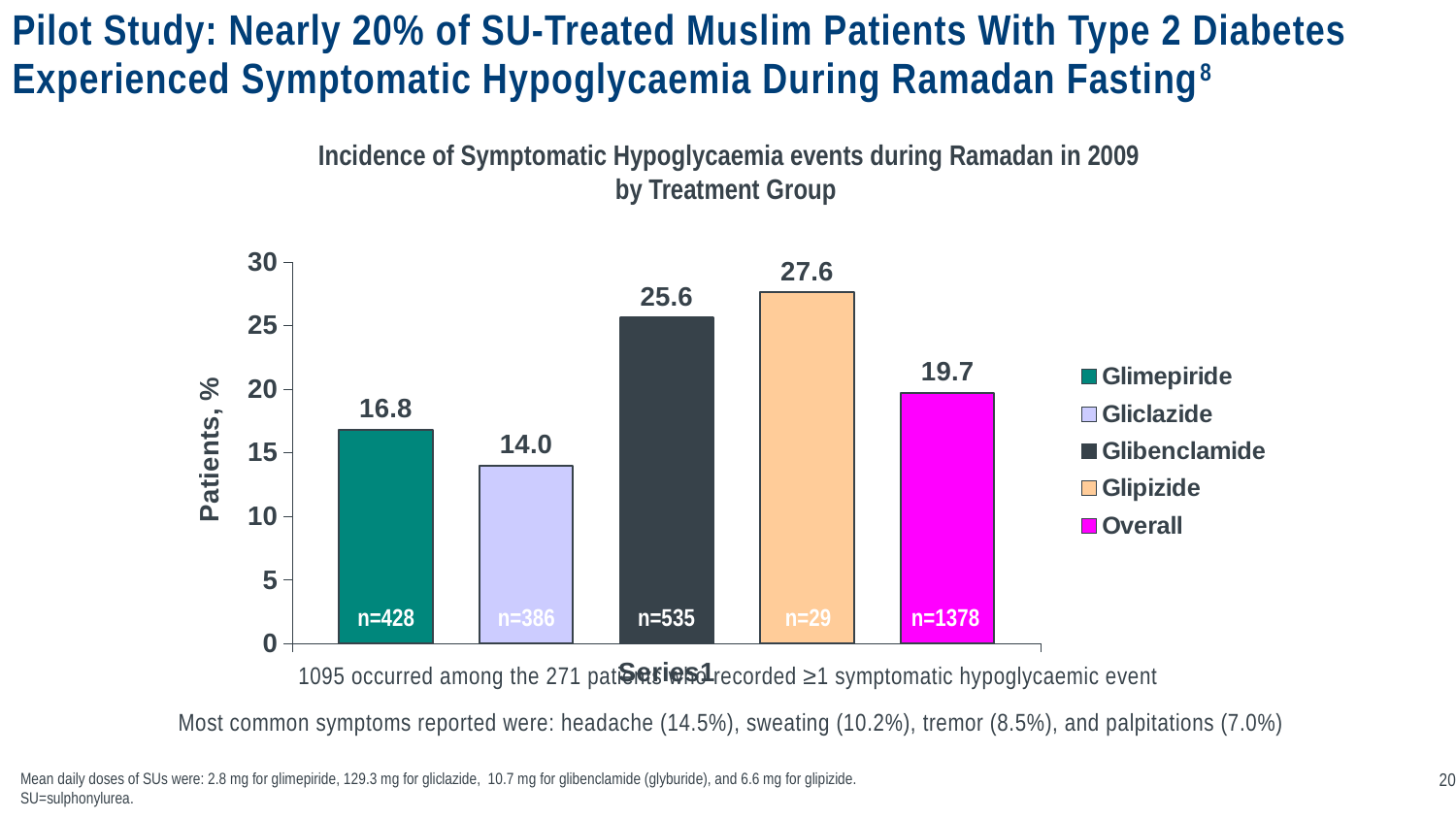
What is the value for Glimepiride? 16.8 Which treatment group has the lowest incidence? Gliclazide What is the value for Gliclazide? 14.0 What is the Overall value? 19.7 Which treatment group has the highest incidence? Glipizide What is the value for Glibenclamide? 25.6 What is the label on the y axis? Patients, % What kind of chart is shown? Bar chart How many series does the legend list? 5 What is the value for Glipizide? 27.6 What is the difference between the Glipizide and Gliclazide values? 13.6 Which is larger, the value for Glibenclamide or the value for Glimepiride? Glibenclamide